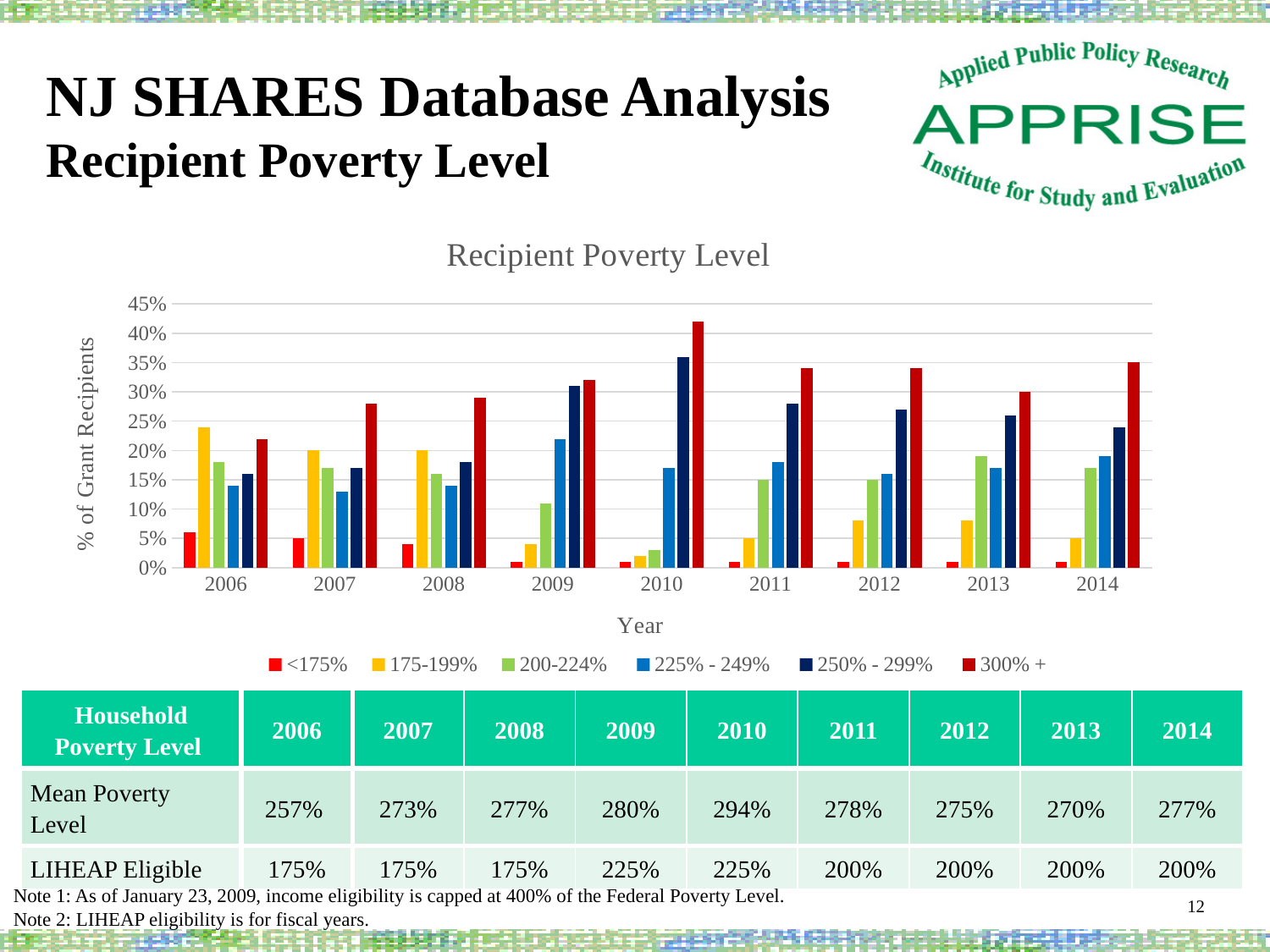
What is the label on the y axis of the chart? % of Grant Recipients How many series does the legend of the Recipient Poverty Level chart list? 6 How many years are shown on the x axis of the Recipient Poverty Level chart? 9 In which year is the 300% + bar the highest? 2010 Is the value for 300% + in 2010 greater or less than 40%? greater In 2006, which is larger: the 175-199% bar or the 225% - 249% bar? 175-199% What kind of chart is shown on the slide? bar chart Is the value for 250% - 299% in 2010 greater or less than 30%? greater Does the <175% series rise or fall from 2006 to 2014? fall Which poverty level group has the lowest bar in 2010? <175% Is the value for <175% in 2006 greater or less than 10%? less Which poverty level group has the highest bar in 2011? 300% +